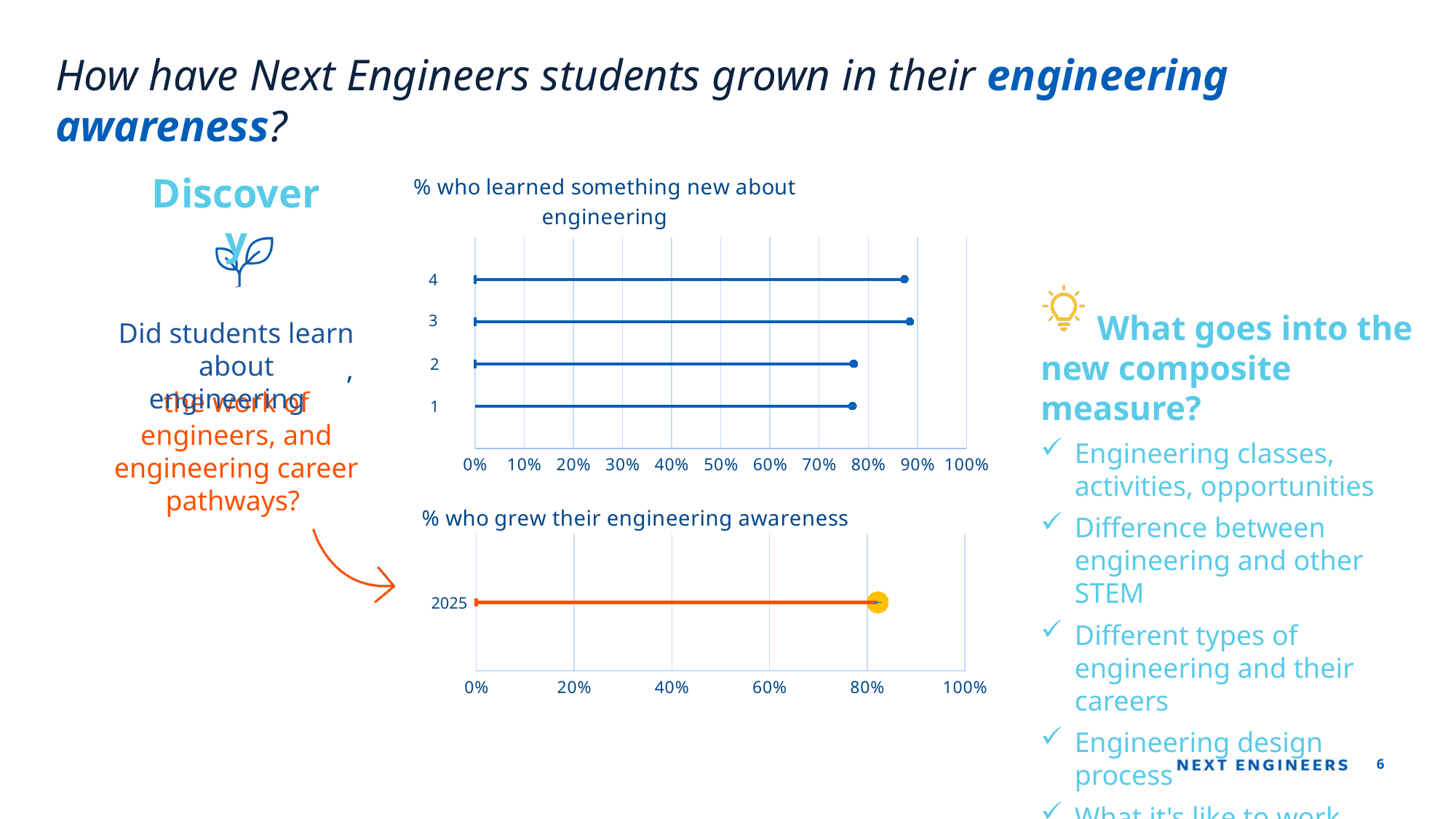
In the chart titled '% who grew their engineering awareness', what is the label of the single category shown? 2025 In the chart titled '% who learned something new about engineering', what is the highest value shown on the x axis? 100% In the chart titled '% who learned something new about engineering', which has the larger value, category 1 or category 4? 4 In the chart titled '% who grew their engineering awareness', how many categories are plotted? 1 In the chart titled '% who learned something new about engineering', is the value for category 4 greater or less than 80%? greater In the chart titled '% who grew their engineering awareness', is the value for 2025 greater or less than 60%? greater What is the title of the lower chart on the slide? % who grew their engineering awareness In the chart titled '% who learned something new about engineering', is the value for category 3 greater or less than 80%? greater In the chart titled '% who learned something new about engineering', which has the larger value, category 3 or category 2? 3 In the chart titled '% who learned something new about engineering', how many categories are plotted? 4